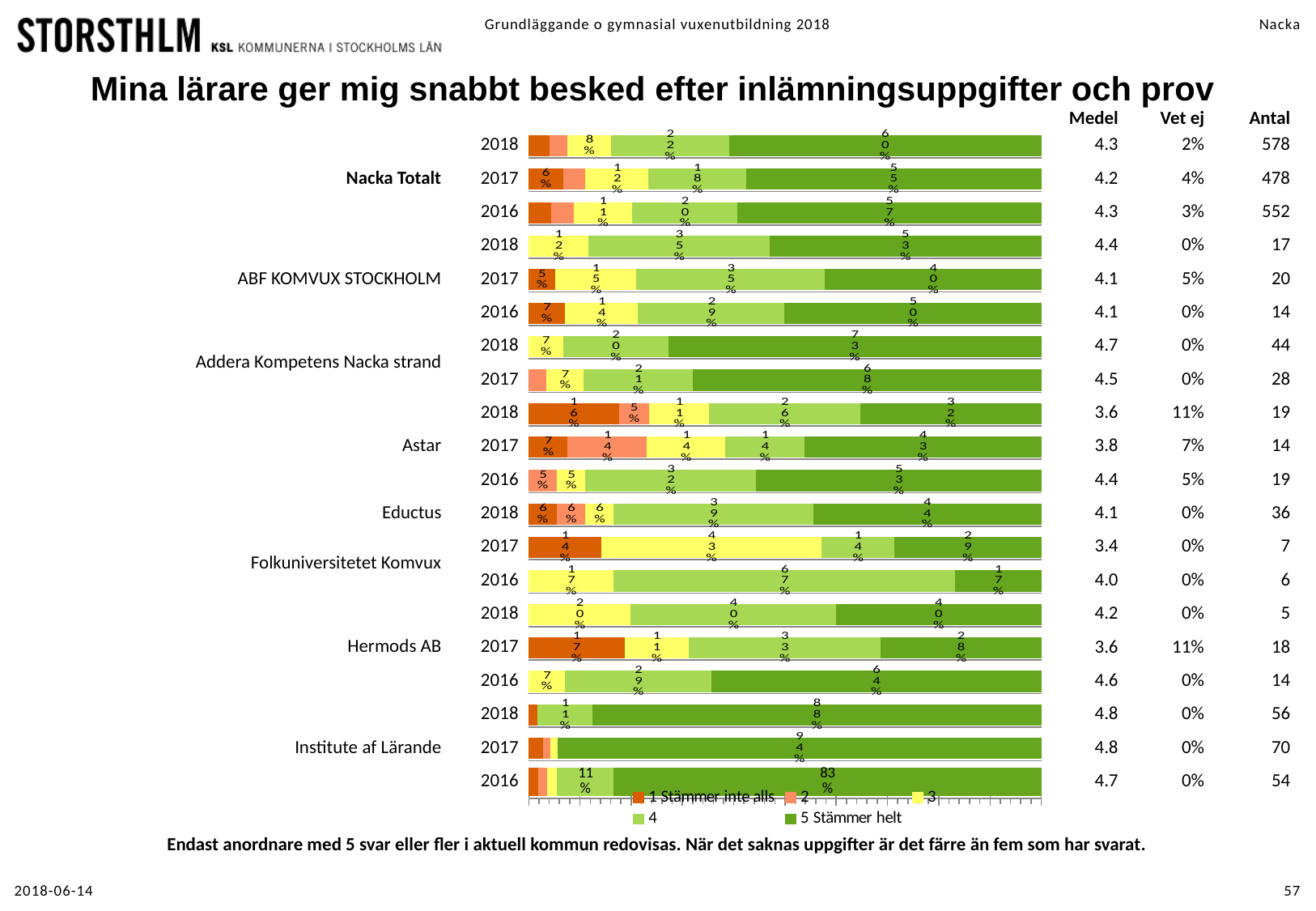
For Institute af Lärande, which year has the highest "5 Stämmer helt" share? 2017 How many series does the legend list? 5 For Hermods AB, which year has the larger "5 Stämmer helt" share, 2016 or 2017? 2016 What is the share for answer "4" for Eductus in 2018? 39% What is the share for answer "4" for Folkuniversitetet Komvux in 2016? 67% What is the "5 Stämmer helt" share for Institute af Lärande in 2017? 94% By how many percentage points does the "5 Stämmer helt" share for Nacka Totalt in 2018 exceed that of 2017? 5 percentage points What is the "1 Stämmer inte alls" share for Astar in 2018? 16% What kind of chart is shown on the slide? Stacked bar chart What percentage of Nacka Totalt respondents in 2018 answered "5 Stämmer helt"? 60% How many bars (provider-year rows) are plotted in the chart? 20 What is the "5 Stämmer helt" share for Addera Kompetens Nacka strand in 2018? 73%